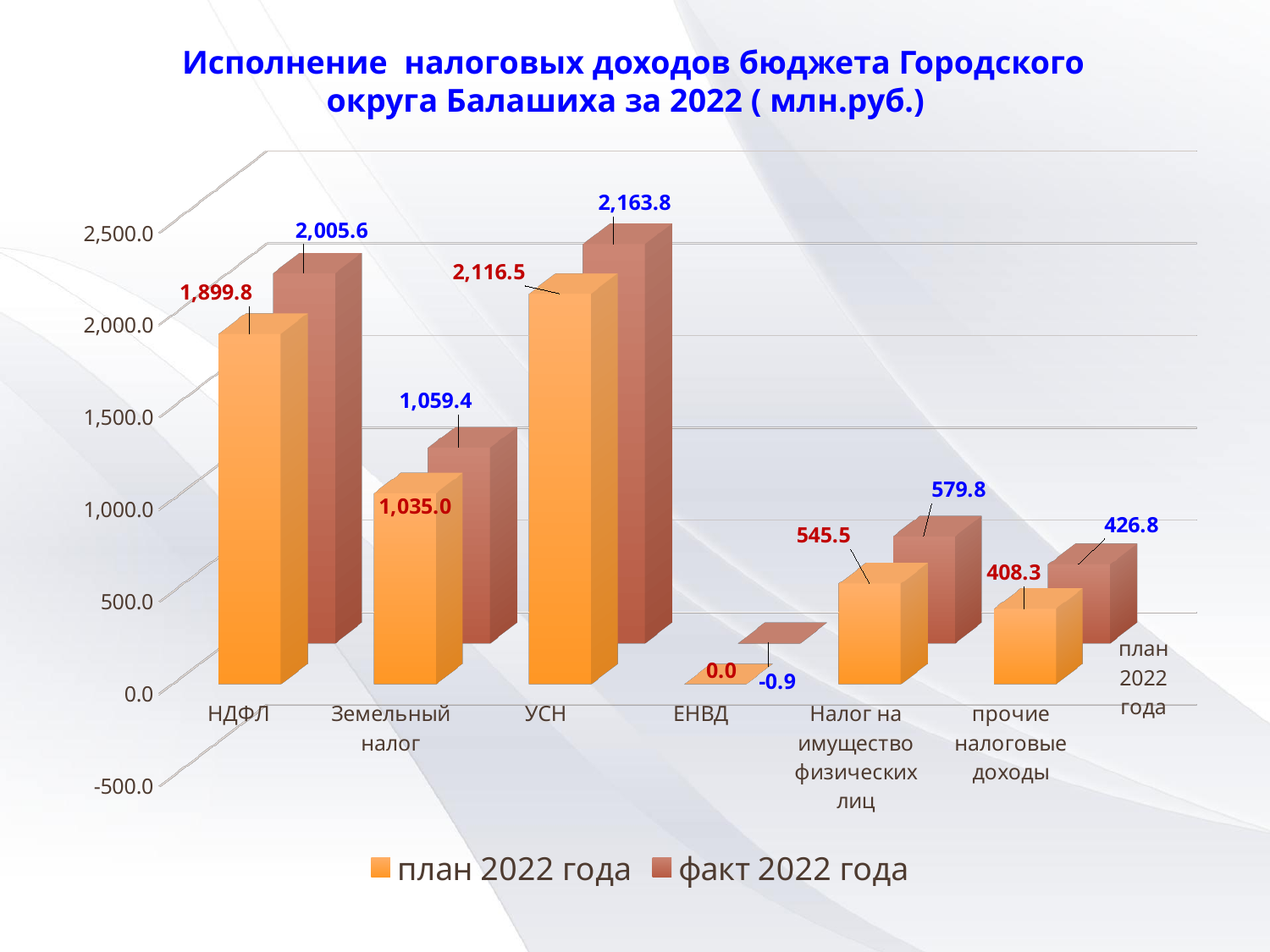
Which category has the highest факт 2022 года value? УСН What is the difference between the факт 2022 года and план 2022 года values for НДФЛ? 105.8 What is the план 2022 года value for прочие налоговые доходы? 408.3 What is the факт 2022 года value for Земельный налог? 1,059.4 What is the план 2022 года value for НДФЛ? 1,899.8 What is the факт 2022 года value for ЕНВД? -0.9 What is the факт 2022 года value for УСН? 2,163.8 What kind of chart is shown on the slide? bar chart Which is larger for Налог на имущество физических лиц: план 2022 года or факт 2022 года? факт 2022 года How many categories are shown on the x axis? 6 Which category has the lowest план 2022 года value? ЕНВД How many series does the legend list? 2